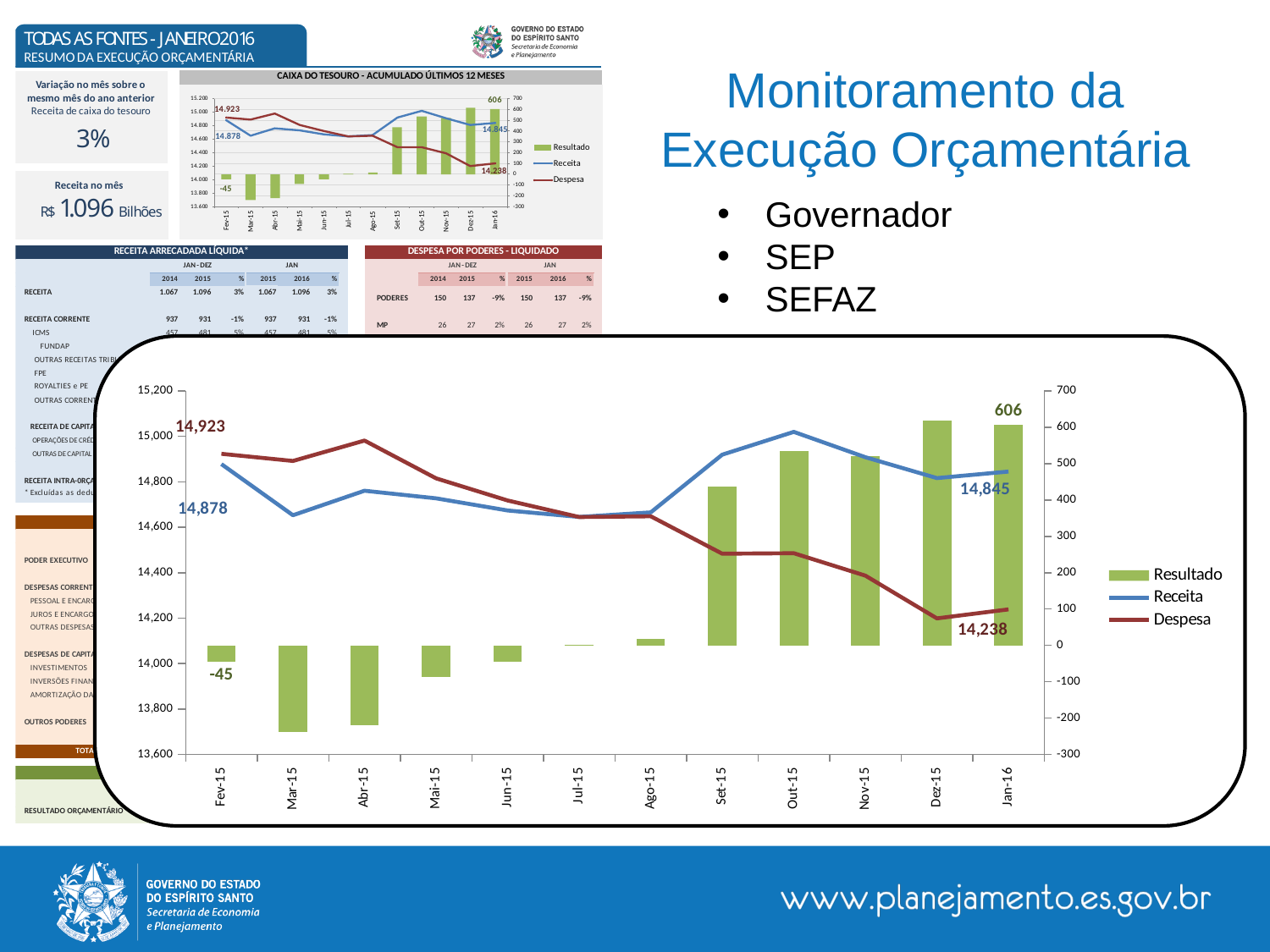
In the large chart, which is larger in Fev-15: Receita or Despesa? Despesa In the large chart, what is the Resultado value for Jan-16? 606 In the large chart, what is the Resultado value for Fev-15? -45 In the large chart, what is the Despesa value for Jan-16? 14,238 In the large chart, what is the Receita value for Jan-16? 14,845 In the large chart, what is the Despesa value for Fev-15? 14,923 How many series does the legend of the large chart list? 3 In the large chart, is the Resultado value for Mar-15 greater or less than -100? less In the large chart, by how much did Despesa fall from Fev-15 to Jan-16? 685 In the large chart, what is the Receita value for Fev-15? 14,878 In the large chart, does the Despesa line generally rise or fall from Fev-15 to Jan-16? fall How many months are shown on the x axis of the large chart? 12